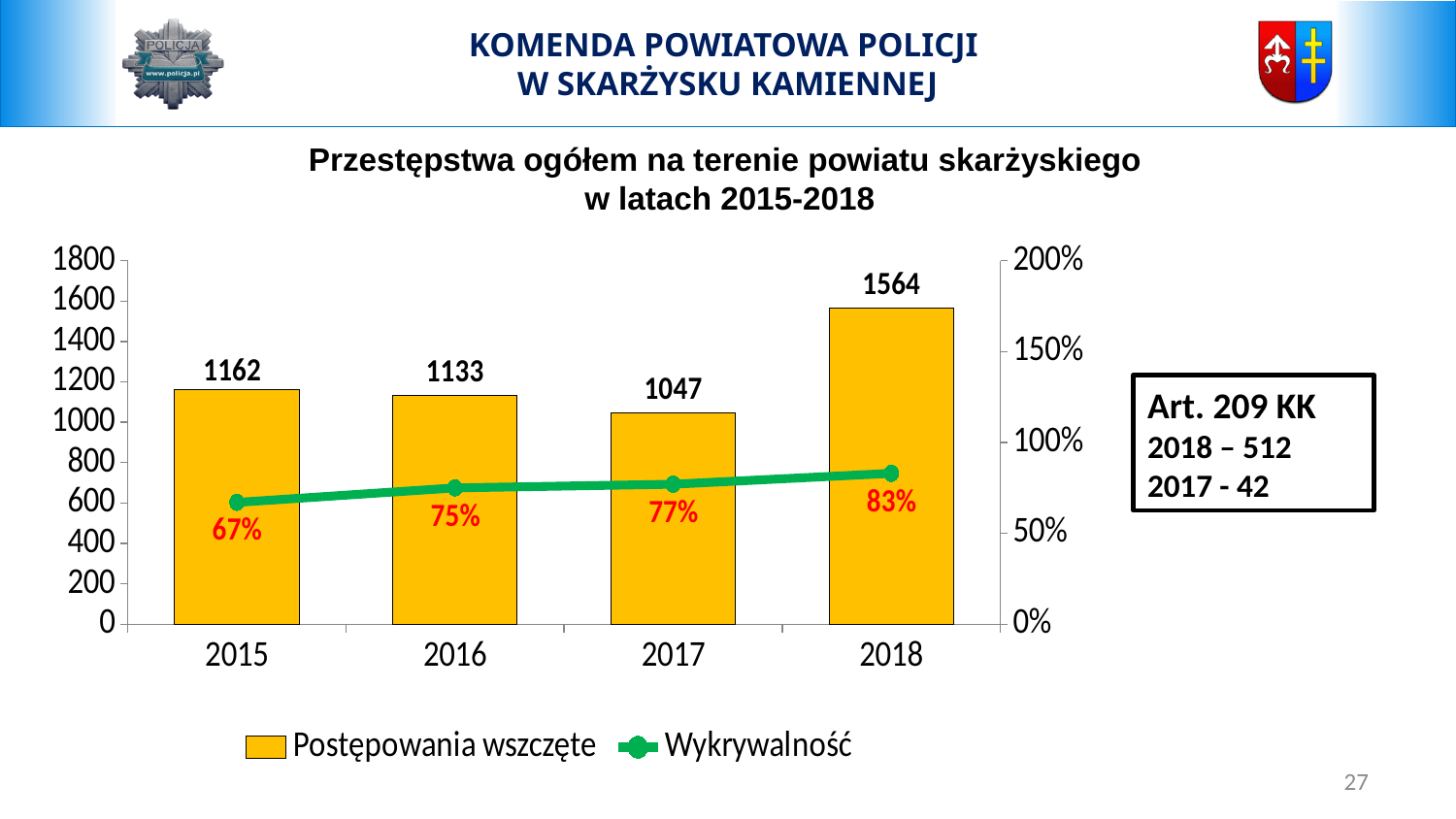
What is the difference between Postępowania wszczęte in 2018 and 2017? 517 Which year has the highest value of Postępowania wszczęte? 2018 What is the difference between Wykrywalność in 2018 and 2015? 16% Does Wykrywalność rise or fall from 2015 to 2018? rise Which year has a higher Wykrywalność, 2016 or 2017? 2017 What is the Wykrywalność value for 2015? 67% What is the value of Postępowania wszczęte for 2018? 1564 How many years are shown on the x axis? 4 Which year has the lowest value of Postępowania wszczęte? 2017 What colour are the bars for Postępowania wszczęte? yellow What is the value of Postępowania wszczęte for 2017? 1047 How many series does the legend list? 2